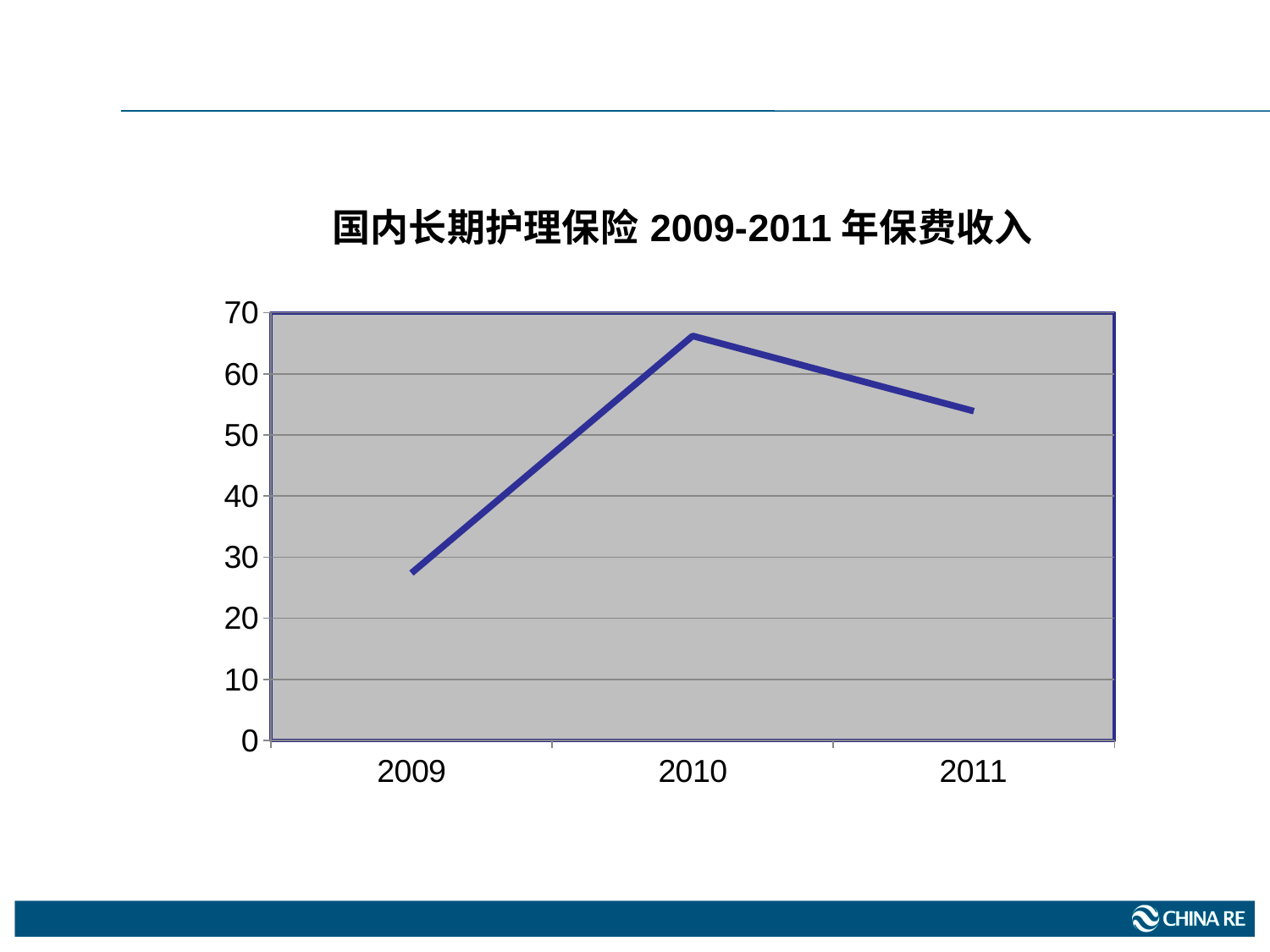
Is the value for 2011 greater or less than 50? greater Is the value for 2010 greater or less than 60? greater Which year has the lowest value in the chart? 2009 Does the line rise or fall from 2010 to 2011? fall How many years are plotted on the x axis of the chart? 3 Which year has the highest value in the chart? 2010 Which is larger, the value for 2009 or the value for 2011? 2011 Is the value for 2009 greater or less than 30? less What kind of chart is shown on the slide? line chart Does the line rise or fall from 2009 to 2010? rise Which is larger, the value for 2010 or the value for 2011? 2010 What is the title of the chart on the slide? 国内长期护理保险 2009-2011 年保费收入